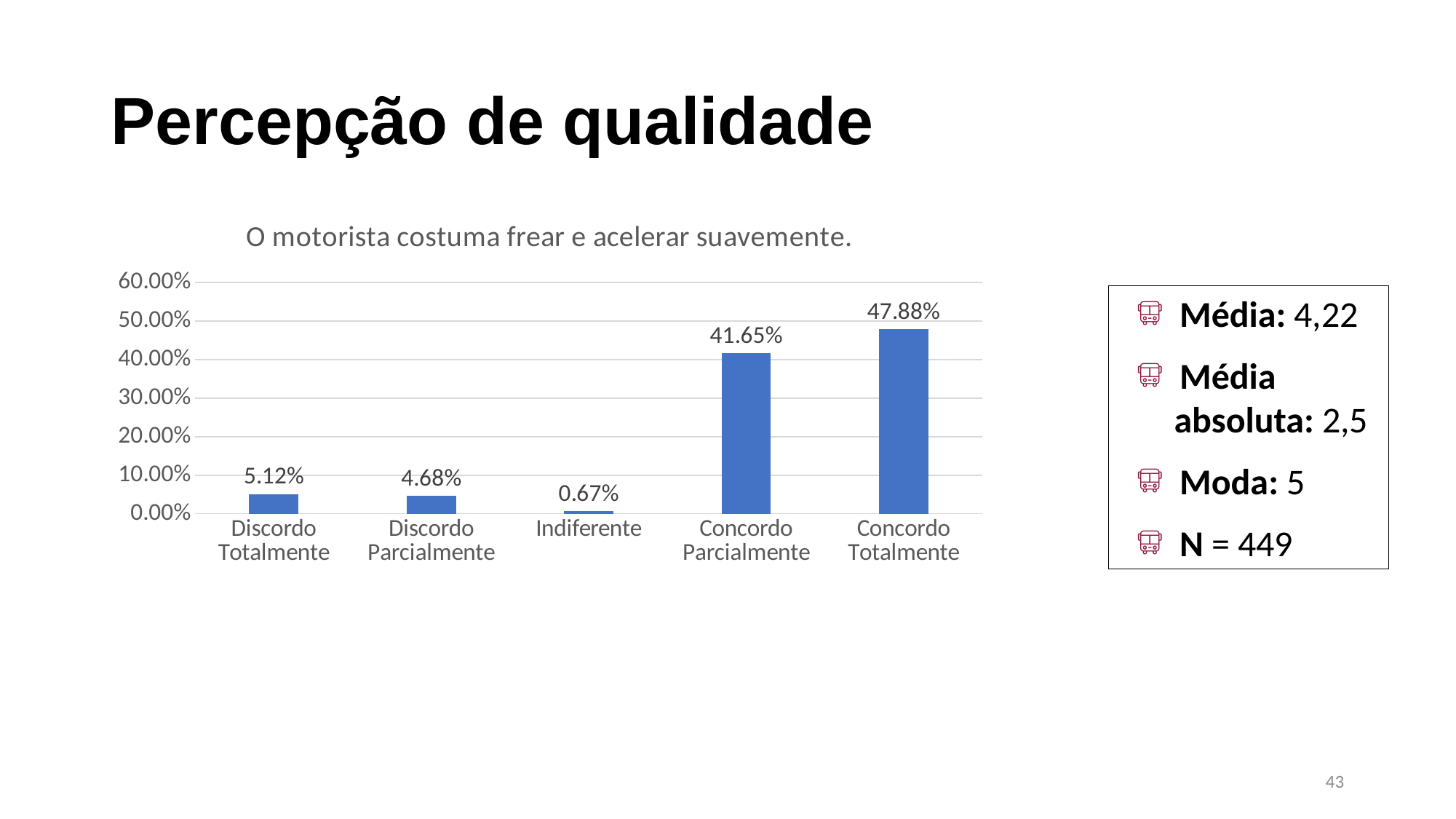
What is the value for Discordo Parcialmente? 4.68% What is the title of the chart? O motorista costuma frear e acelerar suavemente. What is the value for Indiferente? 0.67% Is the value for Concordo Parcialmente greater or less than 40.00%? greater What kind of chart is shown? bar chart What is the difference between Concordo Totalmente and Concordo Parcialmente? 6.23% Which is larger, Discordo Totalmente or Discordo Parcialmente? Discordo Totalmente Which category has the highest value? Concordo Totalmente Which category has the lowest value? Indiferente What is the value for Concordo Totalmente? 47.88% How many categories are shown on the x axis? 5 What is the difference between Discordo Totalmente and Discordo Parcialmente? 0.44%